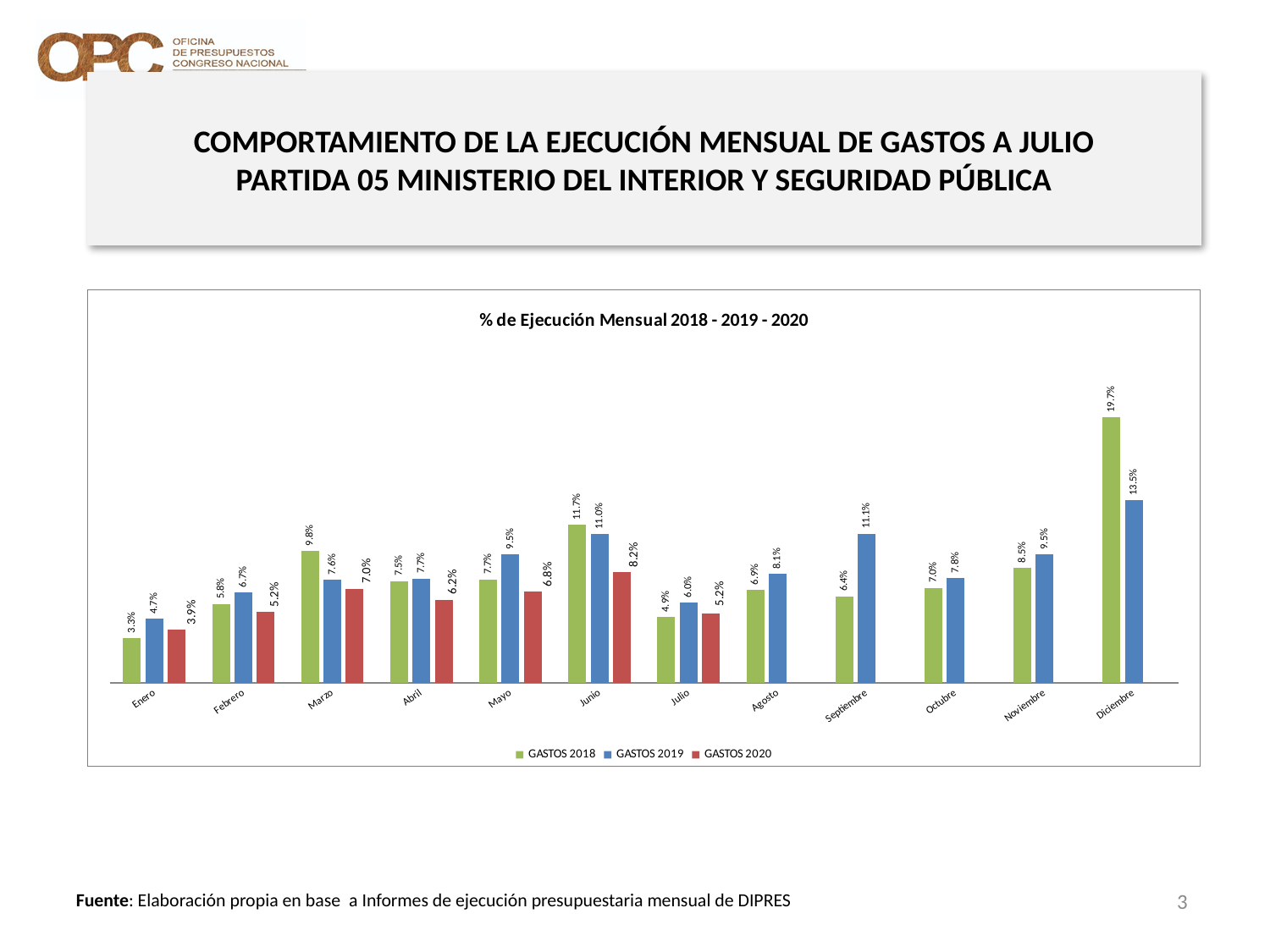
What is the difference between GASTOS 2018 and GASTOS 2019 in Diciembre? 6.2% Which month is the last one with a value for GASTOS 2020? Julio Which month has the lowest value for GASTOS 2020? Enero Which is larger in Marzo: GASTOS 2018 or GASTOS 2019? GASTOS 2018 How many series does the legend list? 3 What is the title of the chart? % de Ejecución Mensual 2018 - 2019 - 2020 What is the value for GASTOS 2020 in Junio? 8.2% What is the value for GASTOS 2019 in Septiembre? 11.1% Which month has the highest value for GASTOS 2018? Diciembre What is the value for GASTOS 2018 in Diciembre? 19.7% How many months are shown on the x axis? 12 What kind of chart is shown on the slide? Bar chart